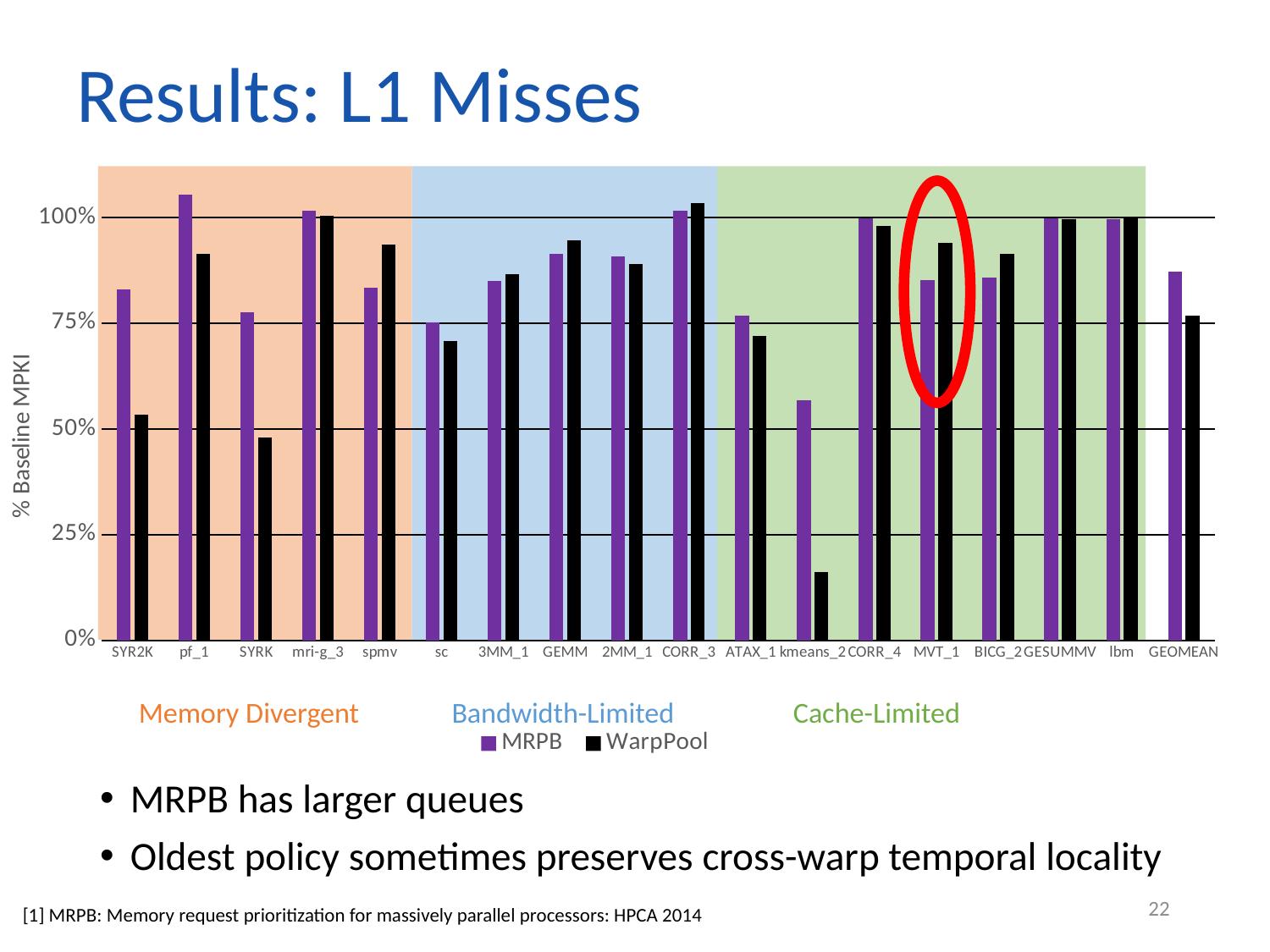
What is the label of the y axis? % Baseline MPKI Is the WarpPool value for SYRK greater or less than 75%? less For kmeans_2, which is larger, the MRPB value or the WarpPool value? MRPB Is the WarpPool value for kmeans_2 greater or less than 25%? less Which category has the lowest WarpPool bar? kmeans_2 Which category's bars are circled in red? MVT_1 How many series does the legend list? 2 How many categories are plotted along the x axis? 18 What kind of chart is shown on the slide? bar chart For SYR2K, which is larger, the MRPB value or the WarpPool value? MRPB Which category has the highest MRPB bar? pf_1 Is the MRPB value for pf_1 greater or less than 100%? greater